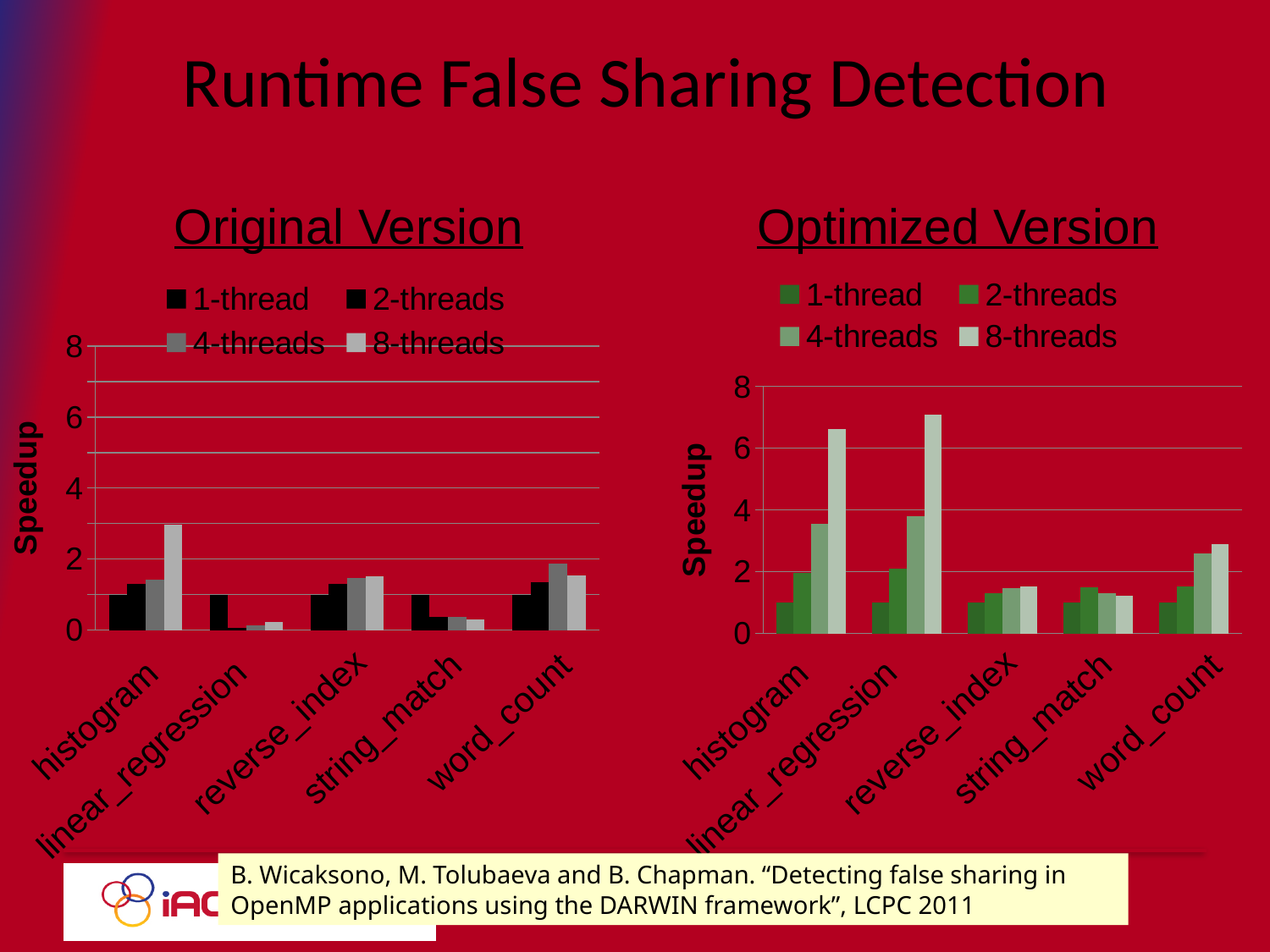
In the Optimized Version chart, is the 8-threads value for linear_regression greater or less than 6? greater What is the label on the vertical axis of the Optimized Version chart? Speedup In the Optimized Version chart, which is larger: the 8-threads value for histogram or the 8-threads value for word_count? histogram How many categories are shown on the x axis of the Original Version chart? 5 In the Original Version chart, is the 8-threads value for histogram greater or less than 2? greater In the Original Version chart, is the 8-threads value for linear_regression greater or less than 2? less How many series does the legend of the Optimized Version chart list? 4 In the Optimized Version chart, which category has the highest 8-threads speedup? linear_regression In the Original Version chart, which category has the highest 8-threads speedup? histogram What kind of chart is the Original Version chart? bar chart In the Original Version chart, which is larger: the 8-threads value for reverse_index or the 8-threads value for string_match? reverse_index